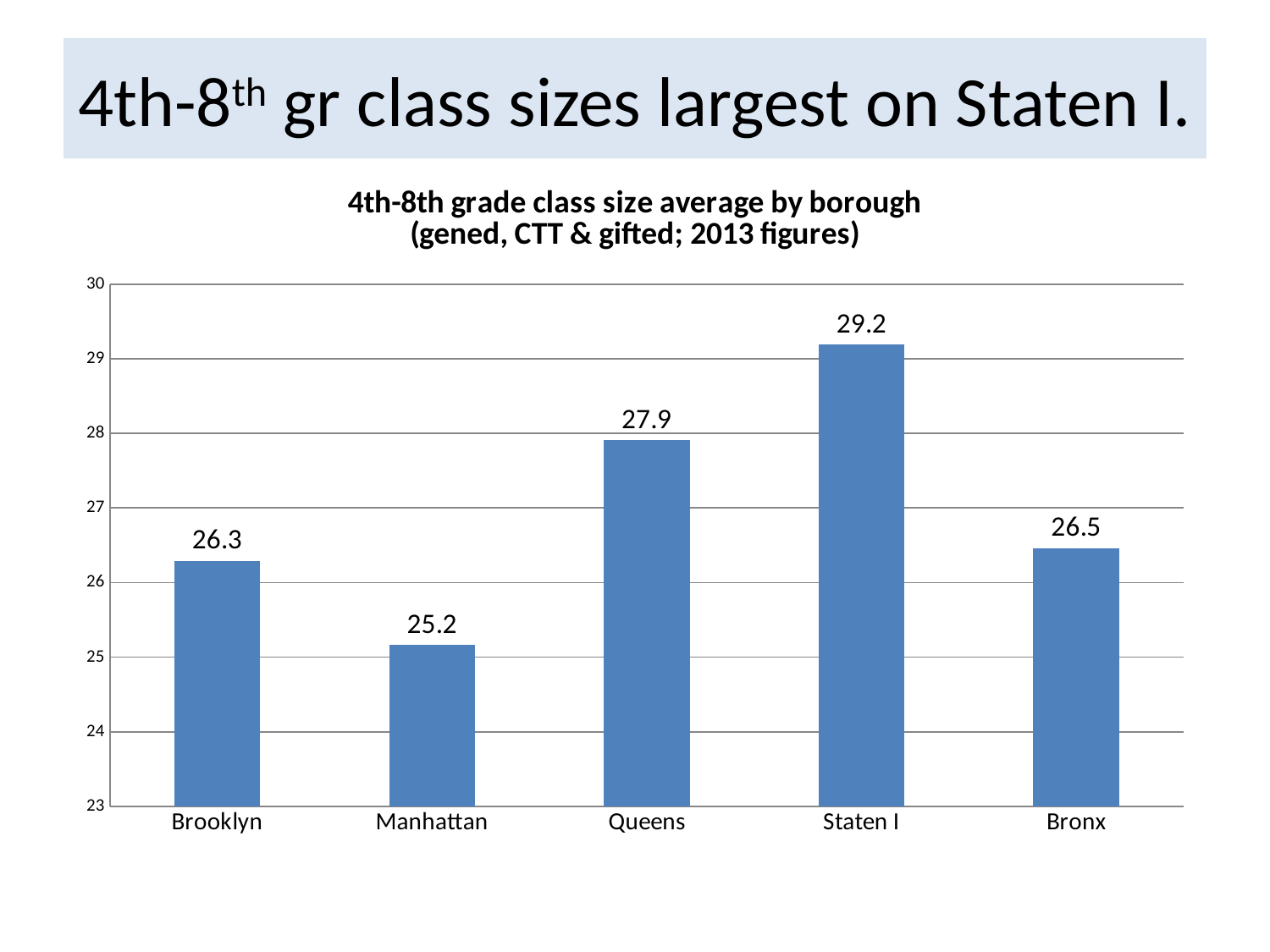
What is the difference between the average class size for Staten I and Manhattan? 4.0 What is the average 4th-8th grade class size for Brooklyn? 26.3 What is the average 4th-8th grade class size for the Bronx? 26.5 What is the difference between the average class size for Queens and Brooklyn? 1.6 Which borough has the largest average 4th-8th grade class size? Staten I Which borough has a larger average class size, Brooklyn or the Bronx? Bronx Is the average class size for Queens greater or less than 28? less Which borough has the smallest average 4th-8th grade class size? Manhattan What is the average 4th-8th grade class size for Manhattan? 25.2 How many boroughs are shown on the chart? 5 What kind of chart is shown on the slide? bar chart What is the average 4th-8th grade class size for Queens? 27.9